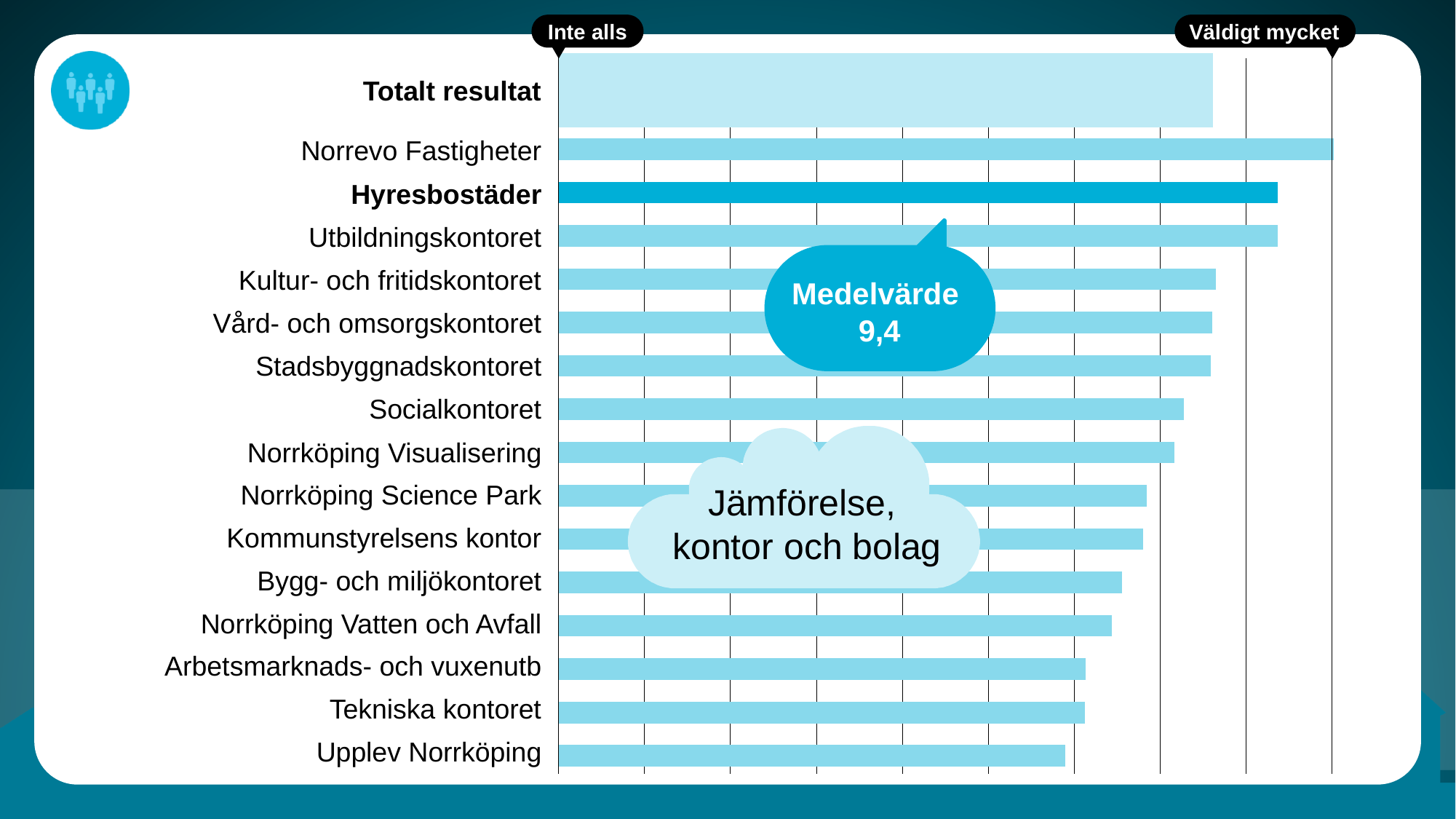
Which organisation has the longest bar in the chart? Norrevo Fastigheter Which has the longer bar, Norrevo Fastigheter or Hyresbostäder? Norrevo Fastigheter Which has the longer bar, Totalt resultat or Norrköping Science Park? Totalt resultat Which has the longer bar, Hyresbostäder or Tekniska kontoret? Hyresbostäder How many bars are plotted in the chart, including Totalt resultat? 16 What are the two labels at the left and right ends of the chart's axis? Inte alls and Väldigt mycket Do the bars get shorter or longer going from Norrevo Fastigheter down to Upplev Norrköping? shorter What kind of chart is shown on the slide? bar chart Which organisation has the shortest bar in the chart? Upplev Norrköping What mean value (Medelvärde) is shown in the callout on the chart? 9,4 How many organisations are listed below Totalt resultat in the chart? 15